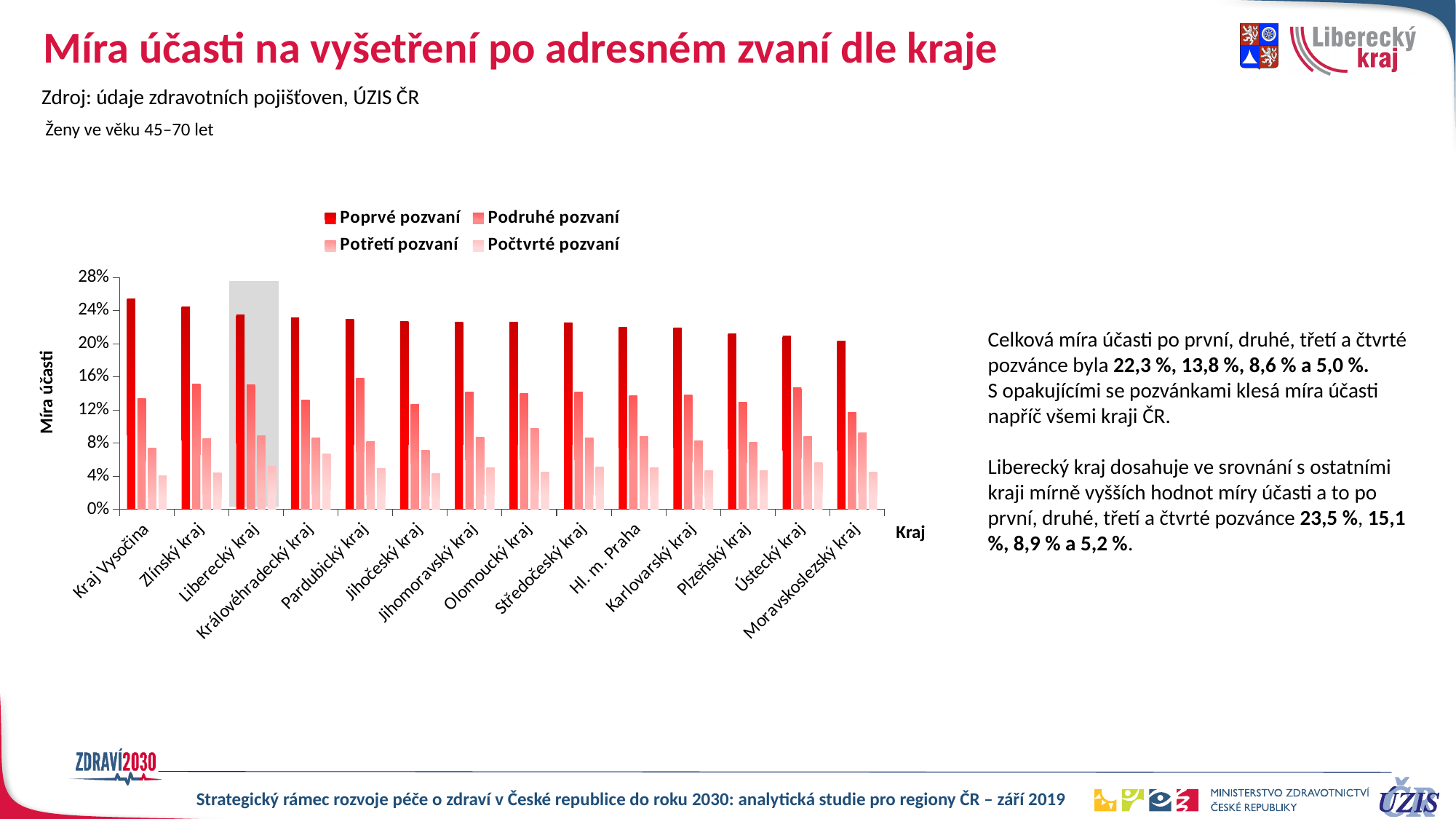
Which is larger: the 'Poprvé pozvaní' value for Kraj Vysočina or for Moravskoslezský kraj? Kraj Vysočina Is the 'Poprvé pozvaní' value for Kraj Vysočina greater or less than 24%? greater Which region has the highest value for 'Poprvé pozvaní'? Kraj Vysočina How many series does the chart legend list? 4 Which region is highlighted with a grey background in the chart? Liberecký kraj What kind of chart is shown on the slide? bar chart Is the 'Poprvé pozvaní' value for Moravskoslezský kraj greater or less than 24%? less Do the 'Poprvé pozvaní' values rise or fall moving from left to right along the x axis? fall Which region has the lowest value for 'Poprvé pozvaní'? Moravskoslezský kraj Is the 'Podruhé pozvaní' value for Pardubický kraj greater or less than 12%? greater How many regions (kraje) are shown on the x axis of the chart? 14 According to the slide, what is the participation rate for Liberecký kraj after the first invitation (Poprvé pozvaní)? 23,5 %